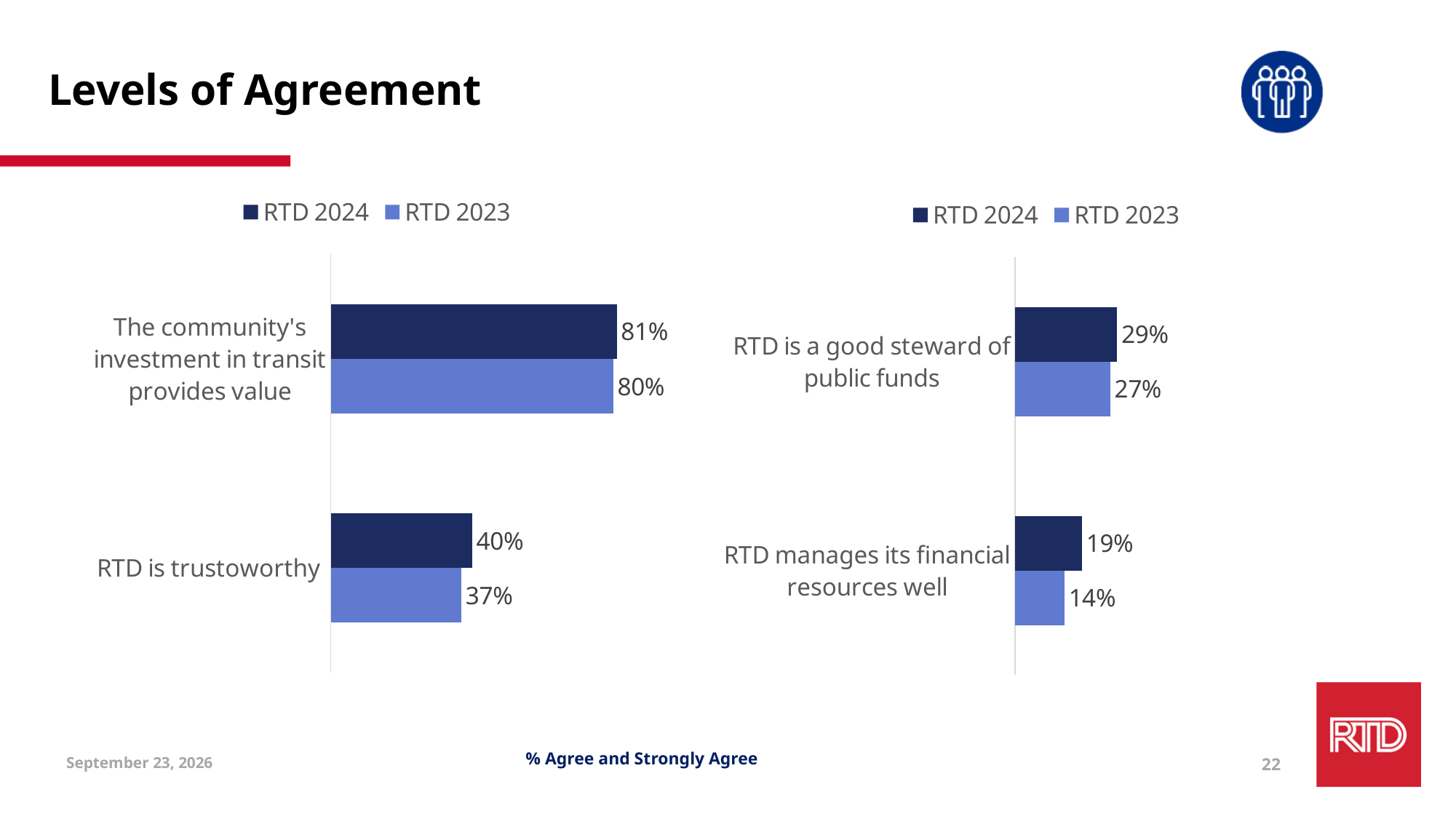
How many series does the legend of the left chart list? 2 In the right chart, what is the RTD 2024 value for "RTD is a good steward of public funds"? 29% How many categories are shown in the right chart? 2 In the right chart, which is larger: the RTD 2024 value for "RTD is a good steward of public funds" or the RTD 2024 value for "RTD manages its financial resources well"? RTD is a good steward of public funds What kind of chart is the left chart? Bar chart In the right chart, what is the difference between the RTD 2024 and RTD 2023 values for "RTD manages its financial resources well"? 5% In the left chart, what is the difference between the RTD 2024 and RTD 2023 values for "RTD is trustoworthy"? 3% In the left chart, which category has the highest RTD 2024 value? The community's investment in transit provides value In the right chart, which category has the lowest RTD 2023 value? RTD manages its financial resources well In the right chart, what is the RTD 2023 value for "RTD manages its financial resources well"? 14% In the left chart, what is the RTD 2024 value for "The community's investment in transit provides value"? 81% In the left chart, what is the RTD 2023 value for "RTD is trustoworthy"? 37%